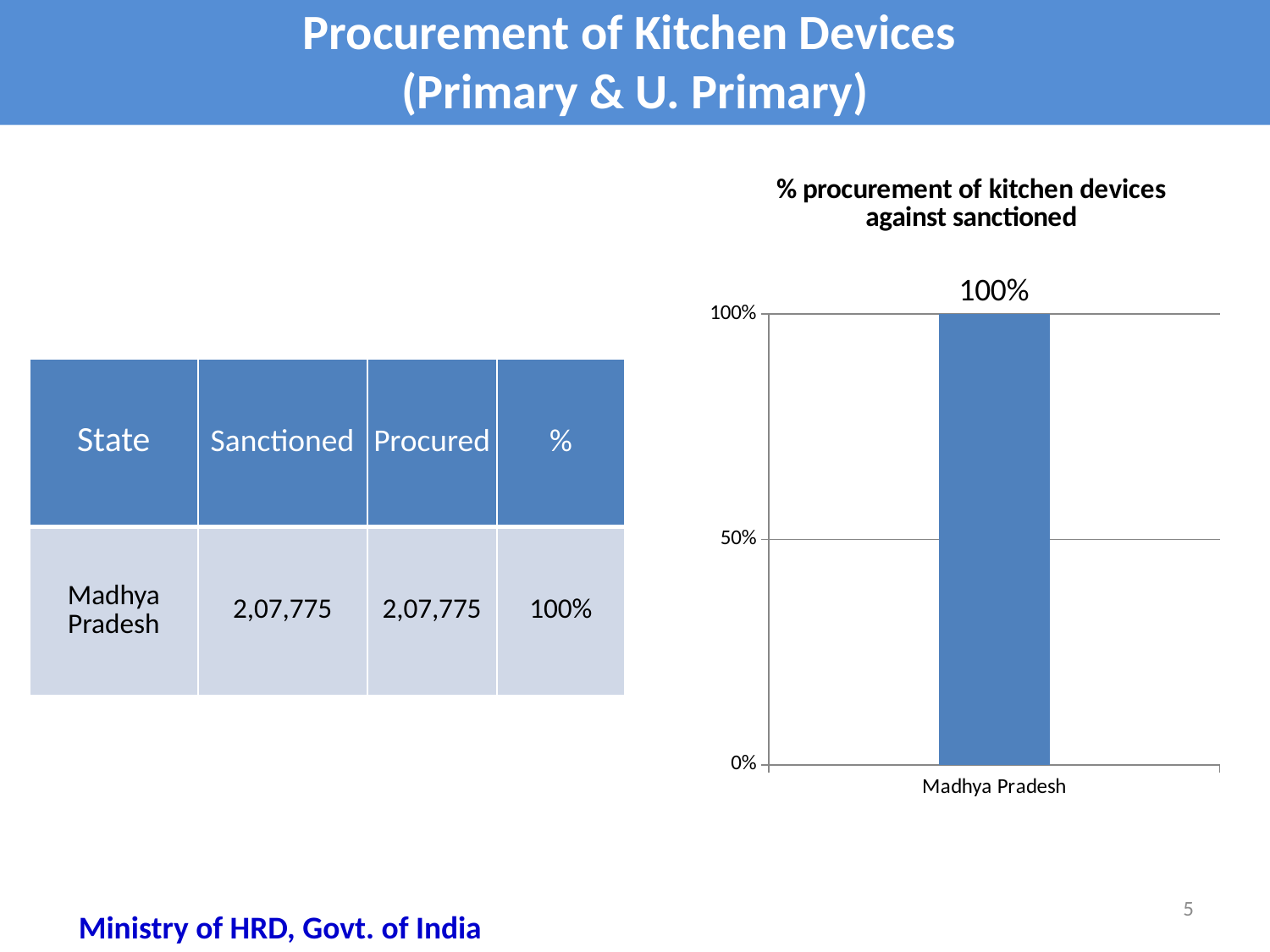
Is the value for Madhya Pradesh greater or less than 50%? greater What is the value for Madhya Pradesh in the chart? 100% What kind of chart is shown on the slide? bar chart What is the lowest value shown on the y axis of the chart? 0% What is the title of the chart? % procurement of kitchen devices against sanctioned Which state is shown on the x axis of the chart? Madhya Pradesh How many categories are plotted in the chart? 1 What is the highest value shown on the y axis of the chart? 100%